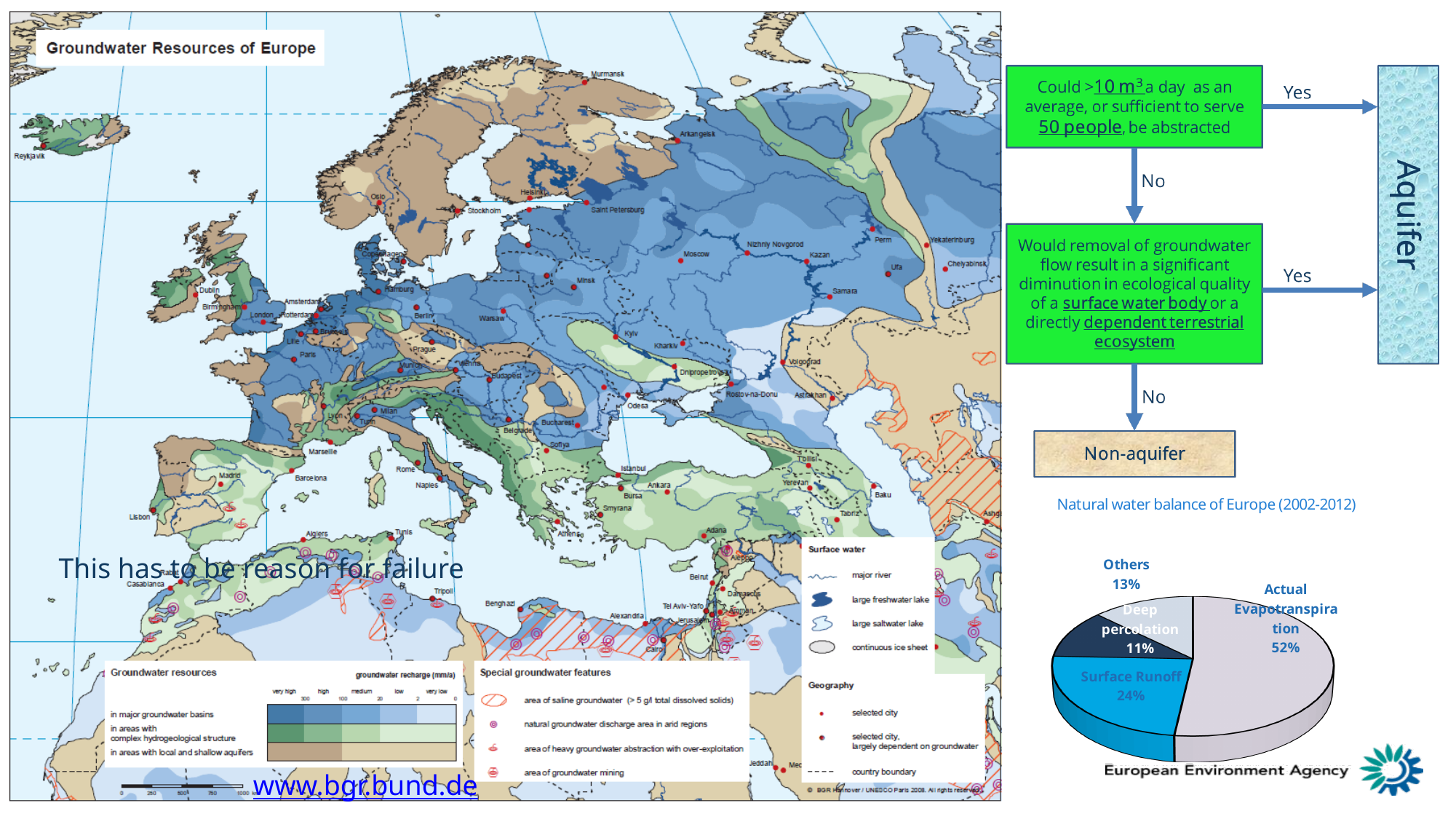
In the 'Natural water balance of Europe (2002-2012)' pie chart, what share is Actual Evapotranspiration? 52% In the 'Natural water balance of Europe (2002-2012)' pie chart, which slice is the smallest? Deep percolation In the 'Natural water balance of Europe (2002-2012)' pie chart, which slice is the largest? Actual Evapotranspiration In the 'Natural water balance of Europe (2002-2012)' pie chart, what share is Surface Runoff? 24% In the 'Natural water balance of Europe (2002-2012)' pie chart, what is the combined share of Surface Runoff and Deep percolation? 35% In the 'Natural water balance of Europe (2002-2012)' pie chart, how many slices are there? 4 In the 'Natural water balance of Europe (2002-2012)' pie chart, which is larger: Others or Deep percolation? Others What kind of chart is the 'Natural water balance of Europe (2002-2012)' chart? pie chart In the 'Natural water balance of Europe (2002-2012)' pie chart, what is the difference in percentage points between Actual Evapotranspiration and Surface Runoff? 28 percentage points Which agency is credited below the 'Natural water balance of Europe (2002-2012)' pie chart? European Environment Agency In the 'Natural water balance of Europe (2002-2012)' pie chart, what share is Others? 13% In the 'Natural water balance of Europe (2002-2012)' pie chart, what share is Deep percolation? 11%